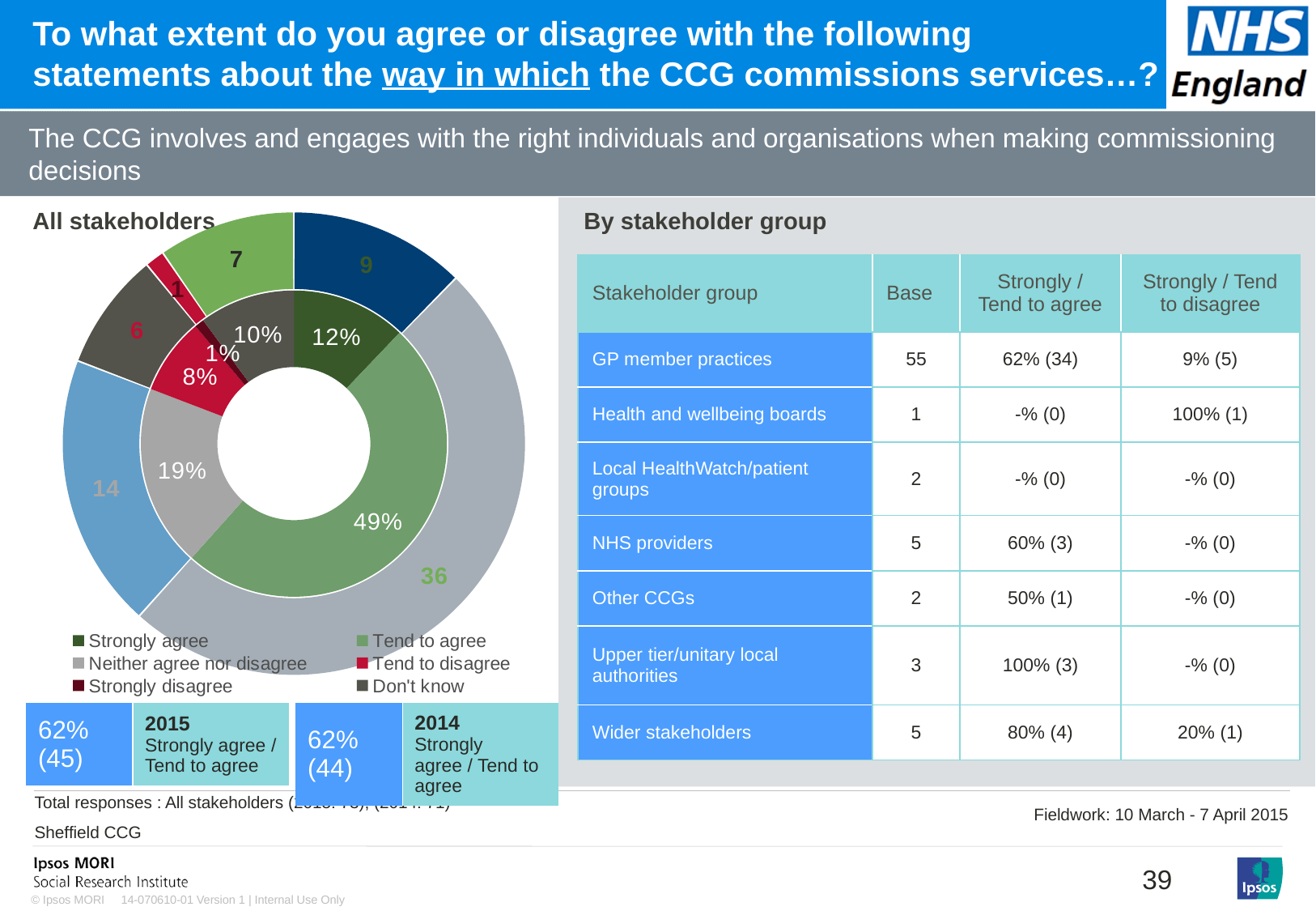
In the All stakeholders chart, what percentage of respondents "Strongly agree"? 12% In the All stakeholders chart, what percentage answered "Don't know"? 10% In the All stakeholders chart, what is the difference in percentage points between "Tend to agree" and "Neither agree nor disagree"? 30 percentage points In the All stakeholders chart, what percentage answered "Strongly disagree"? 1% In the All stakeholders chart, which is larger: the share for "Tend to disagree" or the share for "Don't know"? Don't know In the All stakeholders chart, which response category has the smallest share? Strongly disagree In the All stakeholders chart, what percentage of respondents "Tend to agree"? 49% In the All stakeholders chart, which response category has the largest share? Tend to agree In the All stakeholders chart, what percentage answered "Neither agree nor disagree"? 19% In the All stakeholders chart, what is the largest count shown in the outer ring? 36 How many response categories does the legend of the All stakeholders chart list? 6 What kind of chart is shown under "All stakeholders"? doughnut (pie) chart